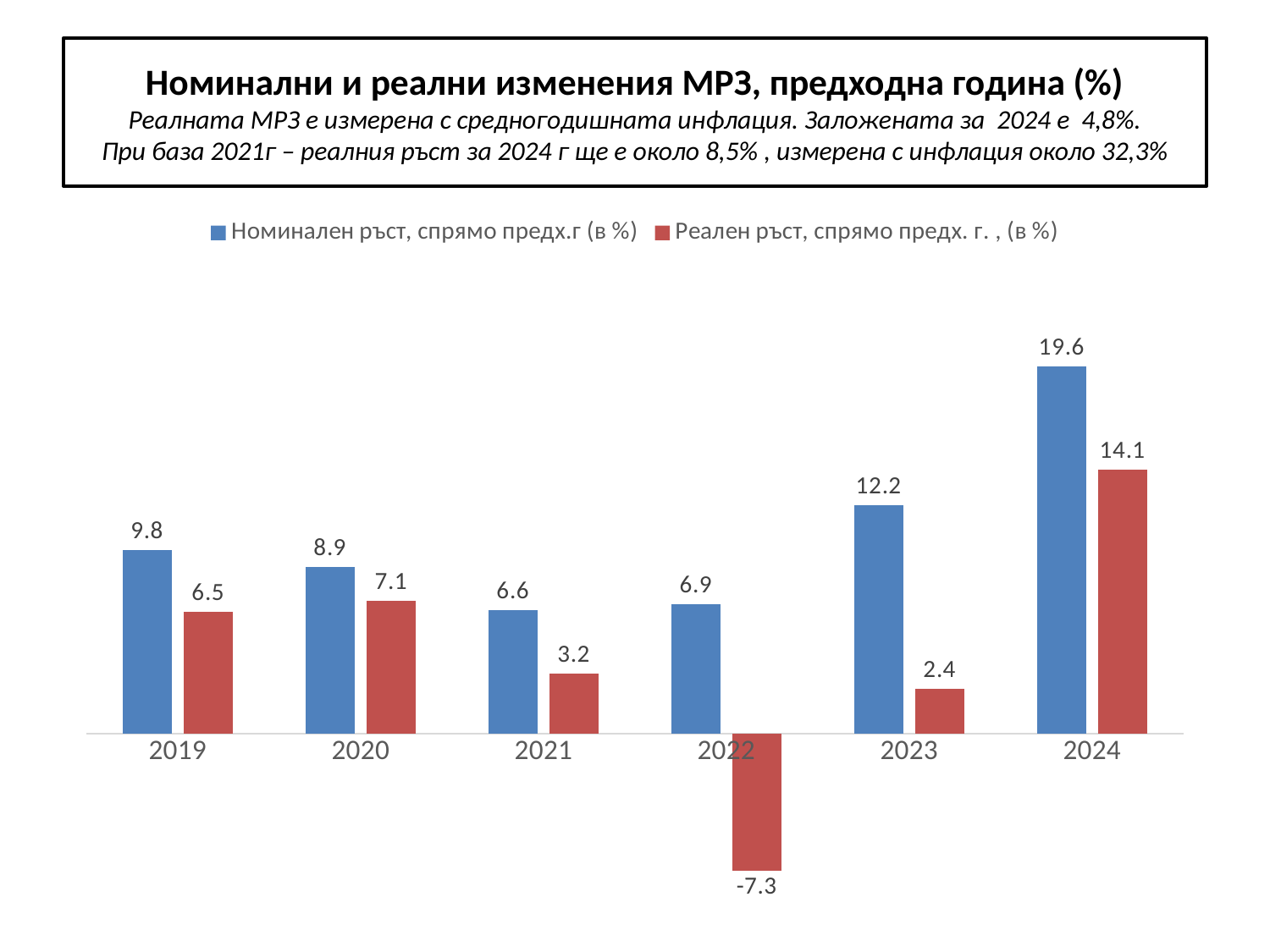
How many years are shown on the x axis? 6 What is the nominal growth (Номинален ръст) value for 2024? 19.6 What is the difference between nominal growth in 2023 and nominal growth in 2022? 5.3 What is the difference between nominal growth and real growth in 2024? 5.5 What is the real growth (Реален ръст) value for 2020? 7.1 How many series does the legend list? 2 Which year has the lowest real growth (Реален ръст)? 2022 What is the real growth (Реален ръст) value for 2022? -7.3 Which is larger: real growth in 2019 or real growth in 2021? 2019 Which year has the lowest nominal growth (Номинален ръст)? 2021 What kind of chart is shown on the slide? Bar chart Which year has the highest nominal growth (Номинален ръст)? 2024